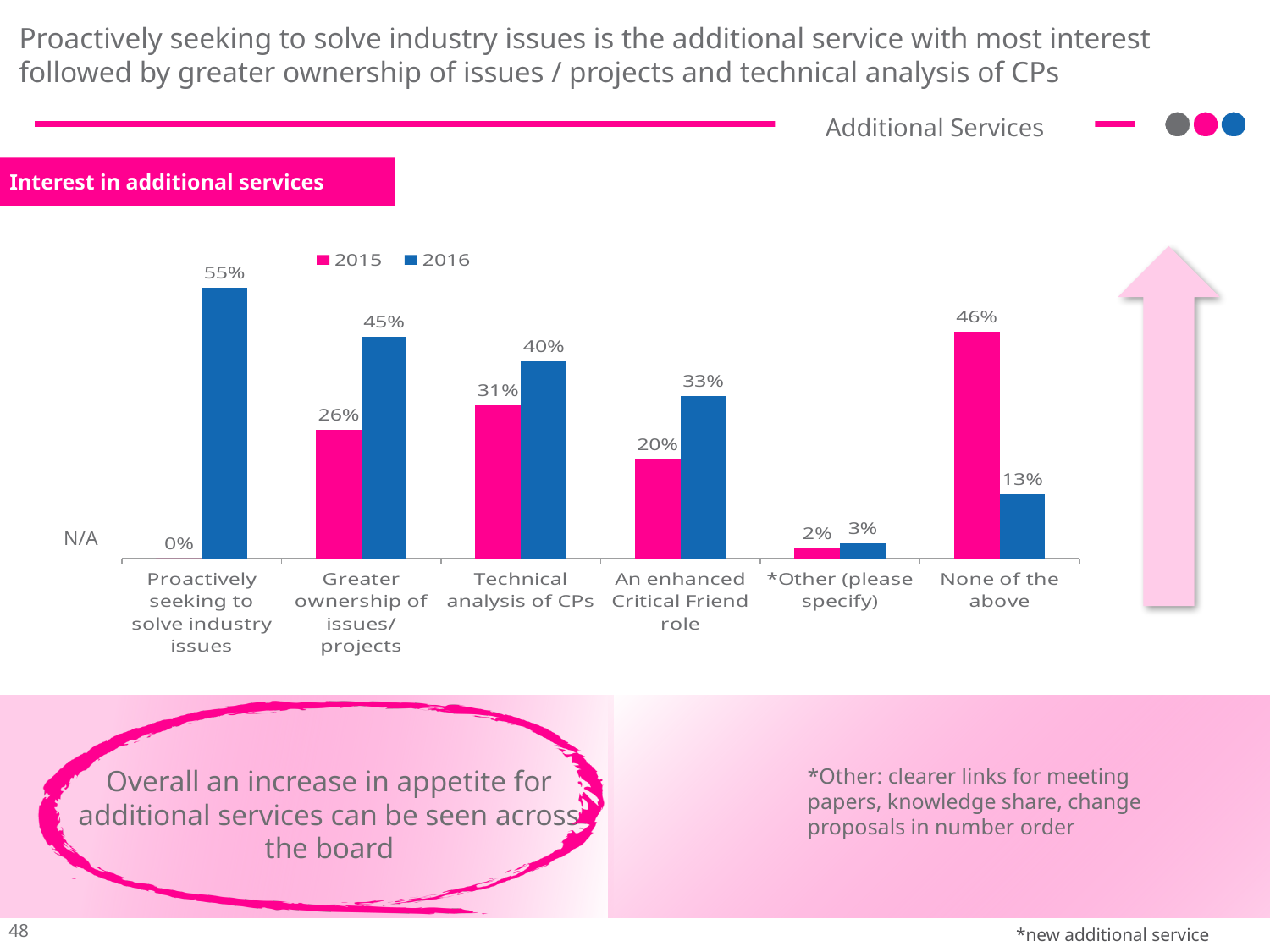
How many series does the legend list? 2 What is the 2016 value for Proactively seeking to solve industry issues? 55% What kind of chart is shown? Bar chart What is the difference between the 2016 and 2015 values for An enhanced Critical Friend role? 13% Which category has the lowest 2015 value? Proactively seeking to solve industry issues Which category has the highest 2016 value? Proactively seeking to solve industry issues What is the 2016 value for Technical analysis of CPs? 40% Which is larger for None of the above: the 2015 value or the 2016 value? 2015 How many categories are shown on the x axis? 6 What is the title of the chart? Interest in additional services What is the 2015 value for None of the above? 46% What is the 2015 value for Greater ownership of issues/projects? 26%